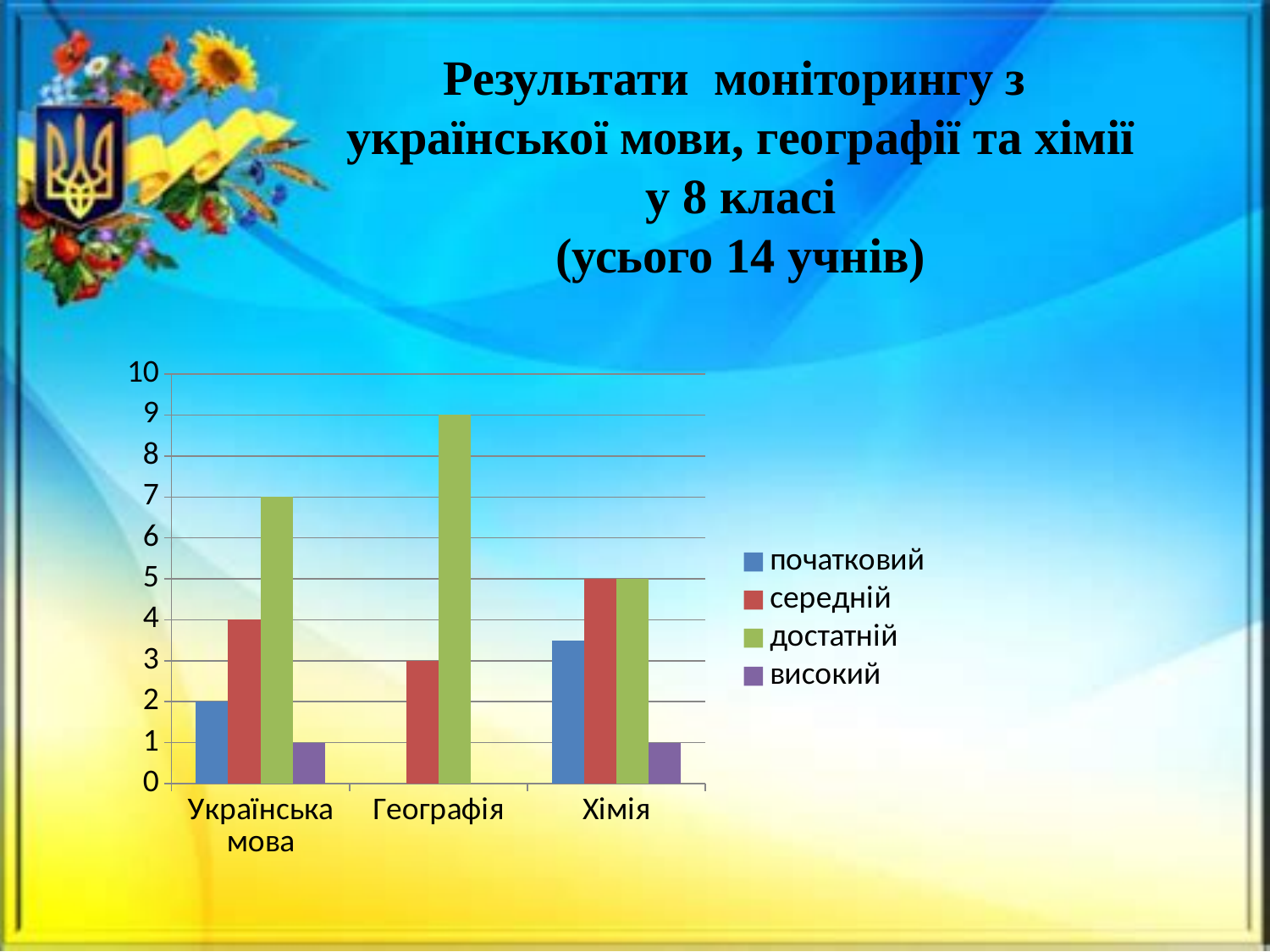
How many categories are shown on the x axis? 3 Which category has the lowest середній value? Географія Is the value of початковий for Хімія greater or less than 3? greater What is the value of середній for Українська мова? 4 What is the value of достатній for Географія? 9 Which category has the highest достатній value? Географія Which is larger: середній for Хімія or середній for Українська мова? середній for Хімія How many series does the legend list? 4 What is the value of достатній for Українська мова? 7 What is the value of середній for Хімія? 5 What is the difference between the достатній values for Географія and Українська мова? 2 What kind of chart is shown on the slide? bar chart